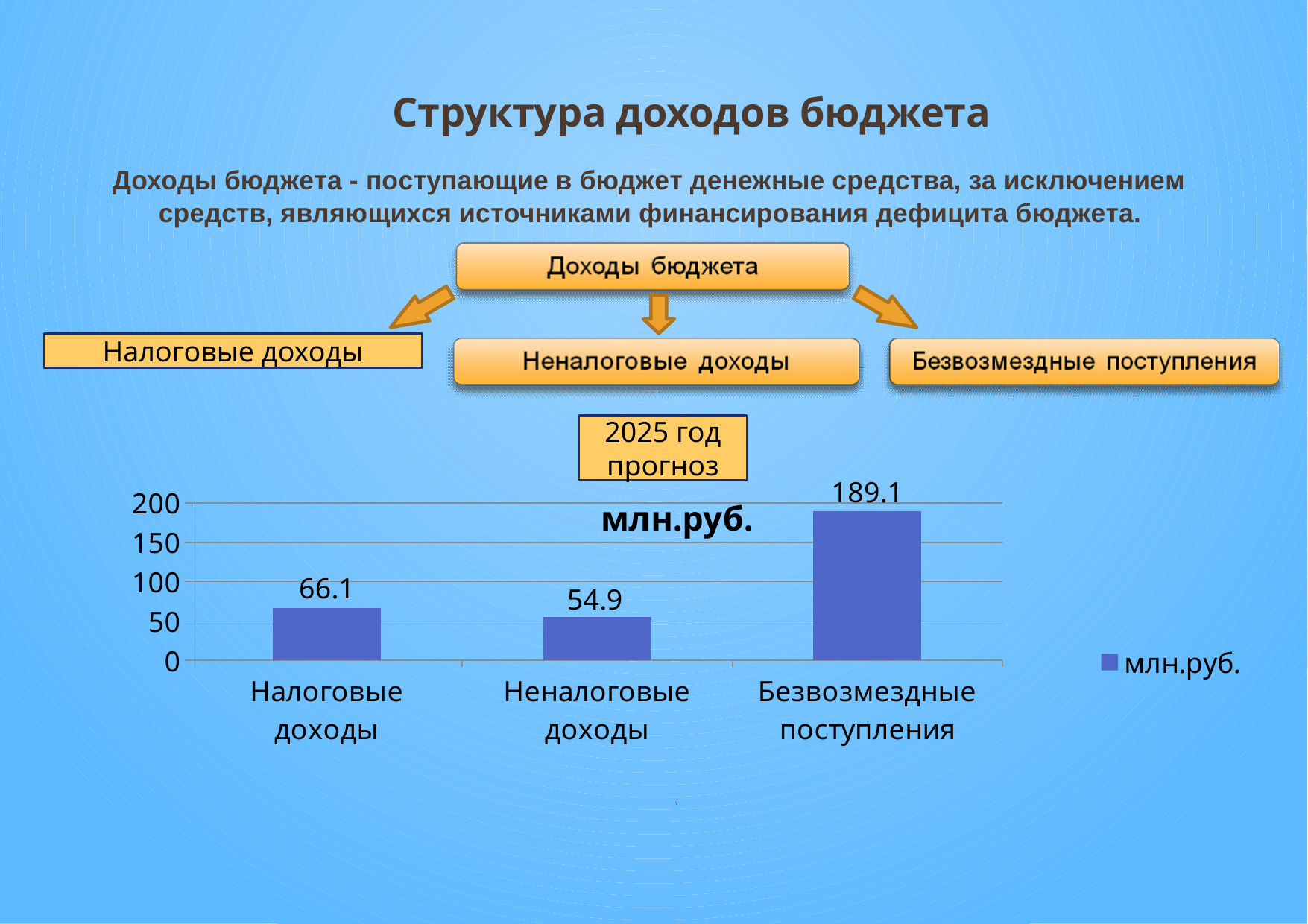
What is the difference between the values for Безвозмездные поступления and Налоговые доходы? 123 What is the difference between the values for Налоговые доходы and Неналоговые доходы? 11.2 What series name does the chart legend list? млн.руб. How many categories are shown in the chart? 3 What kind of chart is shown on the slide? bar chart What is the value for Неналоговые доходы in the chart? 54.9 Is the value for Безвозмездные поступления greater or less than 150? greater Which category has the highest value in the chart? Безвозмездные поступления Which category has the lowest value in the chart? Неналоговые доходы What is the value for Безвозмездные поступления in the chart? 189.1 Which is larger: the value for Налоговые доходы or the value for Неналоговые доходы? Налоговые доходы What is the value for Налоговые доходы in the chart? 66.1